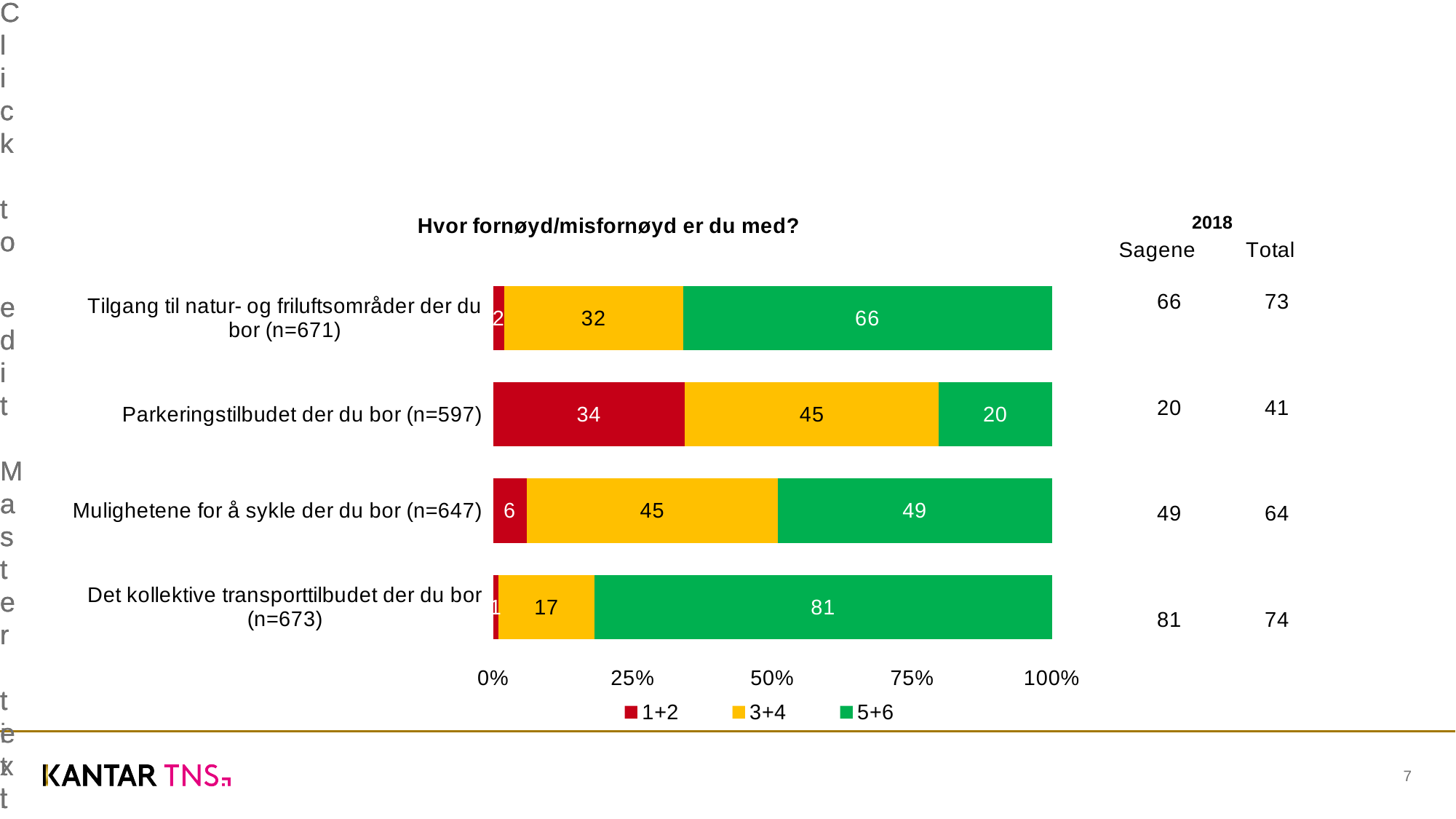
What is the 5+6 value for 'Det kollektive transporttilbudet der du bor (n=673)'? 81 Which is larger: the 3+4 value for 'Parkeringstilbudet der du bor (n=597)' or the 3+4 value for 'Det kollektive transporttilbudet der du bor (n=673)'? Parkeringstilbudet der du bor (n=597) What is the difference between the 5+6 value for 'Mulighetene for å sykle der du bor (n=647)' and the 5+6 value for 'Parkeringstilbudet der du bor (n=597)'? 29 What is the total of the stacked bar for 'Mulighetene for å sykle der du bor (n=647)'? 100 How many series does the legend list? 3 How many categories are plotted in the chart? 4 Which category has the highest 5+6 value? Det kollektive transporttilbudet der du bor (n=673) What kind of chart is shown on the slide? Stacked bar chart What is the 1+2 value for 'Parkeringstilbudet der du bor (n=597)'? 34 Which category has the lowest 5+6 value? Parkeringstilbudet der du bor (n=597) What is the 3+4 value for 'Tilgang til natur- og friluftsområder der du bor (n=671)'? 32 What is the title of the chart? Hvor fornøyd/misfornøyd er du med?